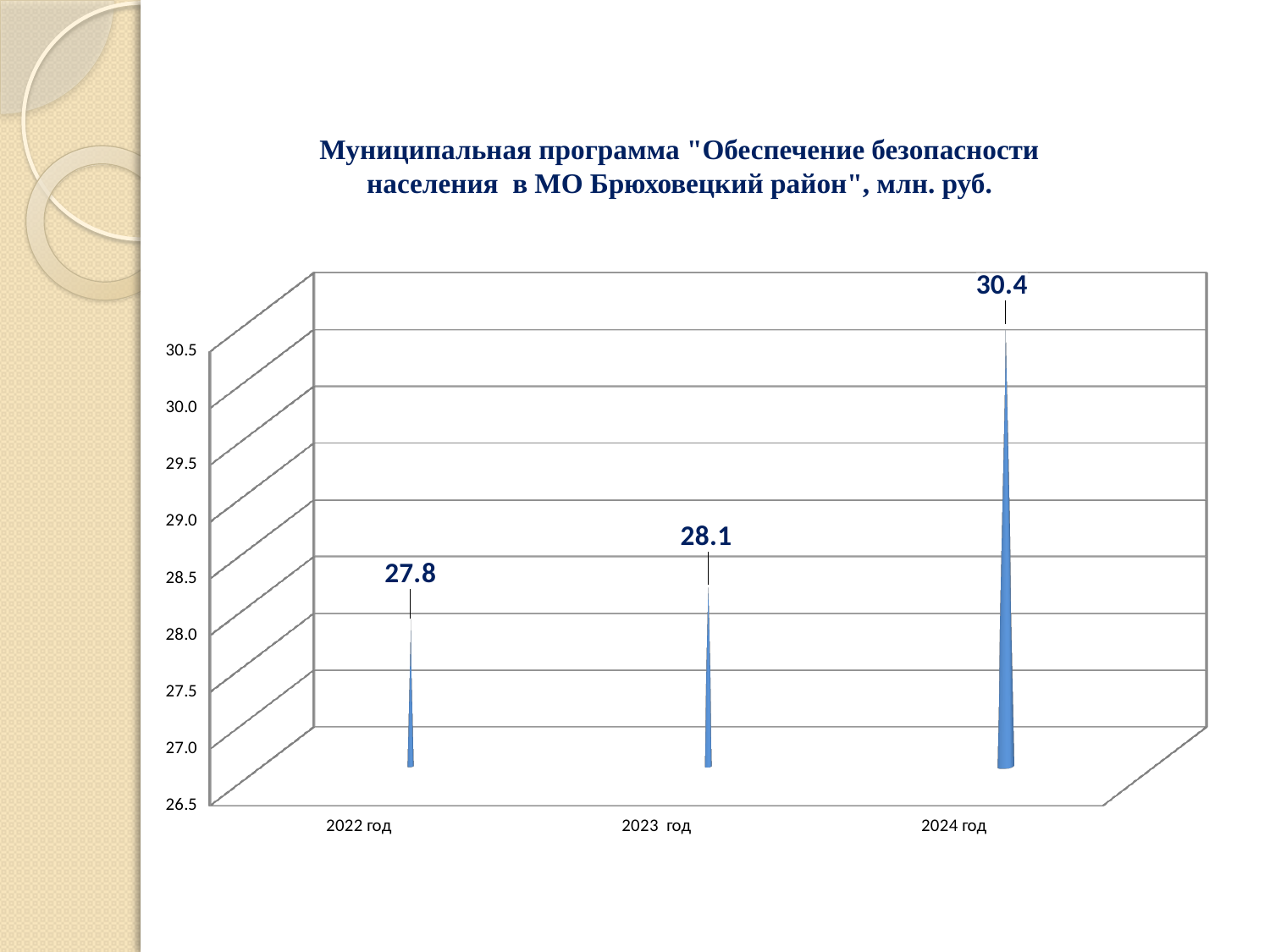
What is the difference between the values for 2024 год and 2022 год? 2.6 Which year has the lowest value? 2022 год Which year has the highest value? 2024 год Which is larger, the value for 2023 год or the value for 2024 год? 2024 год What is the value for 2022 год? 27.8 What is the value for 2023 год? 28.1 What is the value for 2024 год? 30.4 Do the values rise or fall from 2022 год to 2024 год? rise How many years are shown on the x axis? 3 What unit is stated in the chart title? млн. руб. Is the value for 2024 год greater or less than 30.0? greater What is the difference between the values for 2023 год and 2022 год? 0.3